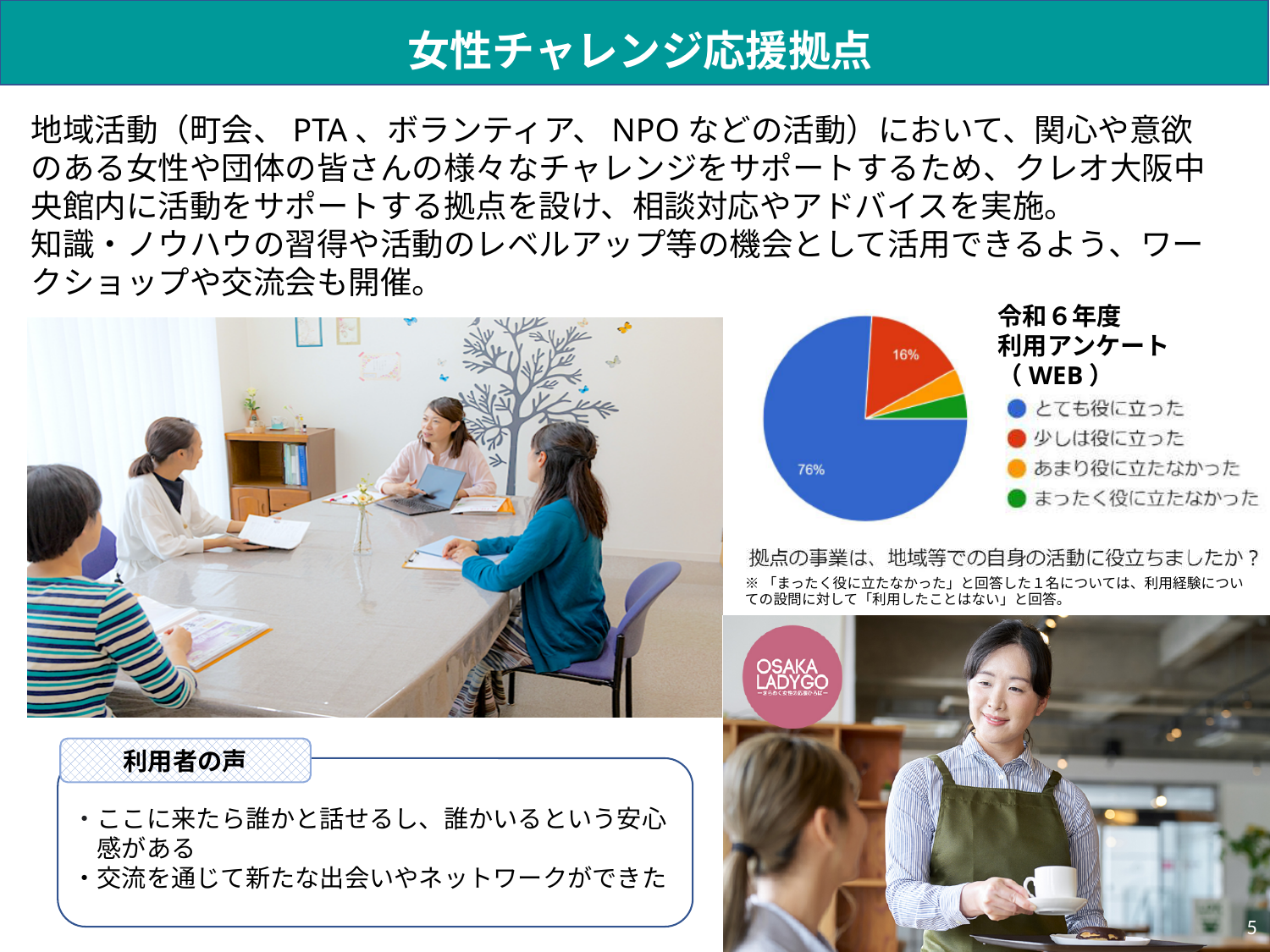
What colour is the slice for 「とても役に立った」? blue What share of the pie does 「とても役に立った」 take? 76% What is the title of the survey shown above the pie chart's legend? 令和6年度 利用アンケート（WEB） What share of the pie does 「少しは役に立った」 take? 16% Which is larger, the slice for 「あまり役に立たなかった」 or the slice for 「とても役に立った」? とても役に立った What is the difference in percentage points between the 「とても役に立った」 slice and the 「少しは役に立った」 slice? 60 Which response category has the largest slice of the pie? とても役に立った Which is larger, the slice for 「とても役に立った」 or the slice for 「少しは役に立った」? とても役に立った How many response categories does the pie chart's legend list? 4 What kind of chart is shown on the slide? pie chart